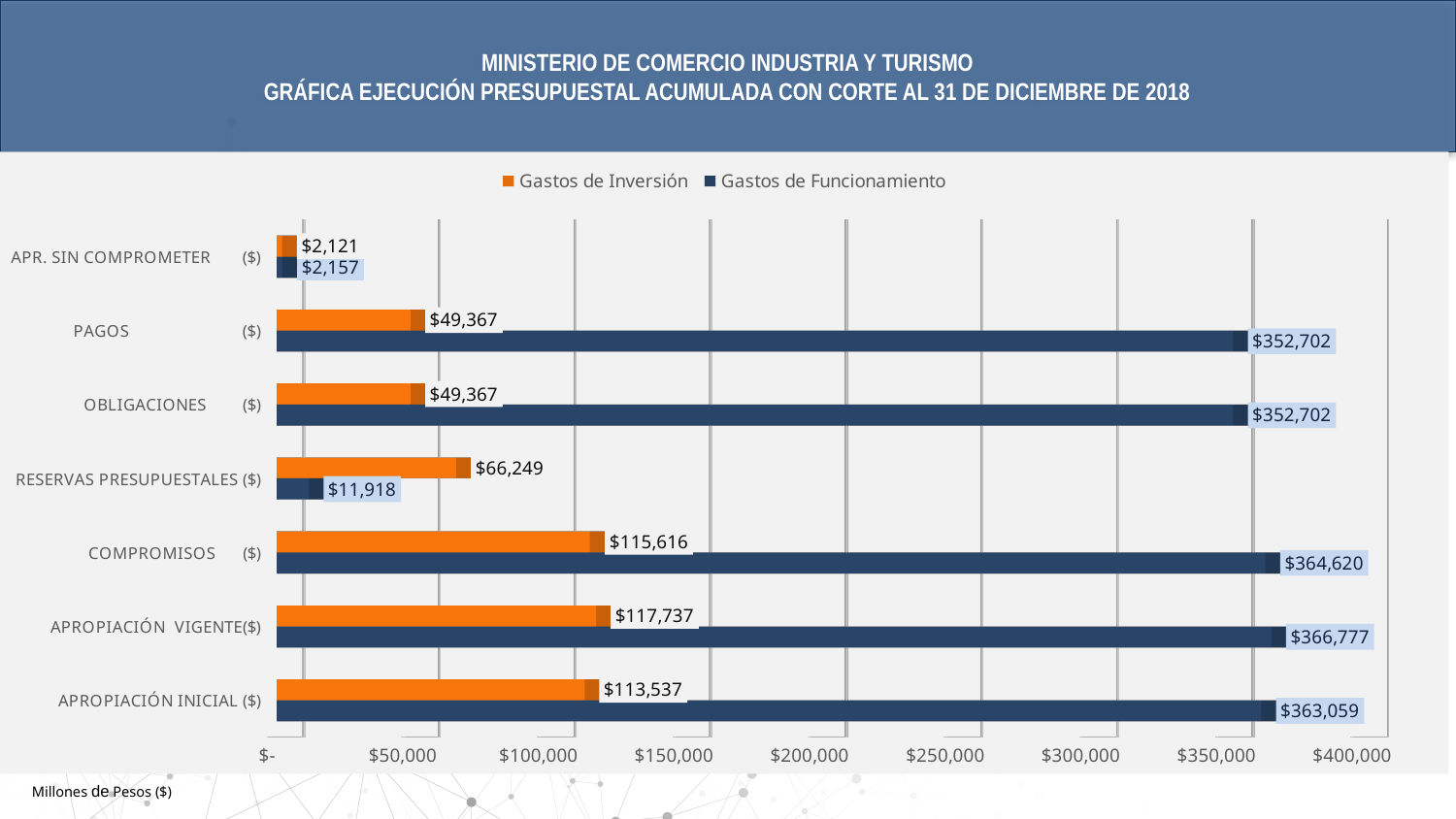
What is the value of Gastos de Inversión for RESERVAS PRESUPUESTALES? $66,249 What is the value of Gastos de Inversión for APROPIACIÓN VIGENTE? $117,737 What is the difference between Gastos de Funcionamiento and Gastos de Inversión for COMPROMISOS? $249,004 What is the value of Gastos de Funcionamiento for APR. SIN COMPROMETER? $2,157 For RESERVAS PRESUPUESTALES, which is larger: Gastos de Inversión or Gastos de Funcionamiento? Gastos de Inversión How many categories are shown on the chart? 7 Is the Gastos de Funcionamiento value for APROPIACIÓN INICIAL greater or less than $350,000? greater What kind of chart is shown on the slide? Bar chart Which category has the highest Gastos de Funcionamiento value? APROPIACIÓN VIGENTE What is the value of Gastos de Funcionamiento for PAGOS? $352,702 How many series does the legend list? 2 Which category has the lowest Gastos de Inversión value? APR. SIN COMPROMETER